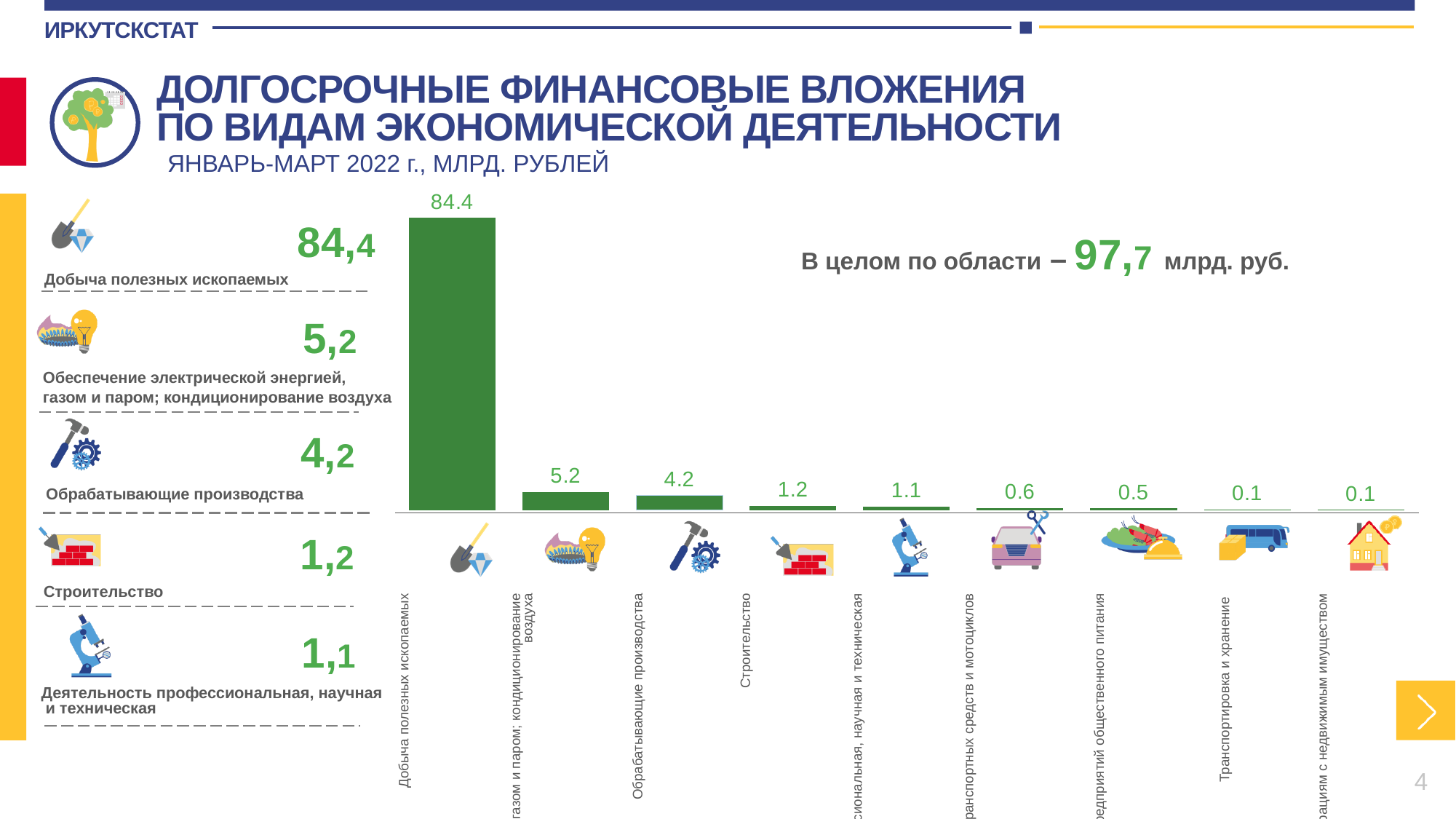
What total for the region as a whole is stated on the slide, in млрд. руб.? 97,7 Do the values rise or fall from left to right along the x axis? fall What is the difference between the values for Добыча полезных ископаемых and Обеспечение электрической энергией, газом и паром; кондиционирование воздуха? 79.2 Which is larger, the value for Строительство or the value for Деятельность профессиональная, научная и техническая? Строительство What is the value for Транспортировка и хранение? 0.1 Which category has the highest value? Добыча полезных ископаемых How many bars are shown in the chart? 9 What is the difference between the values for Обрабатывающие производства and Строительство? 3.0 What kind of chart is shown on the slide? bar chart What is the value for Строительство? 1.2 What is the value for Добыча полезных ископаемых? 84.4 What is the value for Обрабатывающие производства? 4.2